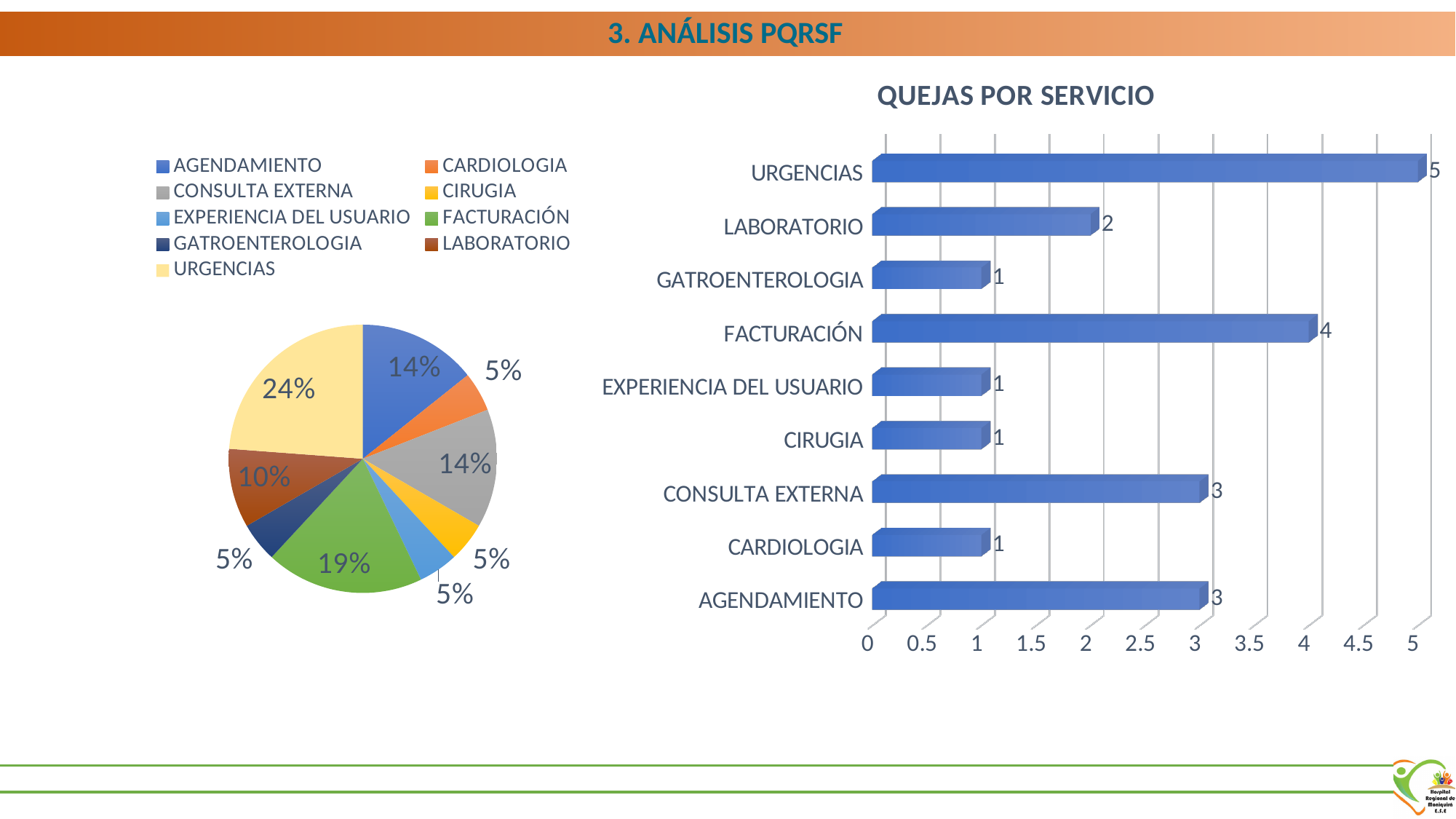
In the bar chart titled QUEJAS POR SERVICIO, how many services are shown? 9 In the bar chart titled QUEJAS POR SERVICIO, which service has the highest value? URGENCIAS In the pie chart on the left, what share does LABORATORIO have? 10% In the pie chart on the left, what share does FACTURACIÓN have? 19% In the bar chart titled QUEJAS POR SERVICIO, which is larger, the value for CONSULTA EXTERNA or the value for LABORATORIO? CONSULTA EXTERNA In the bar chart titled QUEJAS POR SERVICIO, what is the difference between the values for URGENCIAS and LABORATORIO? 3 What kind of chart is the chart titled QUEJAS POR SERVICIO? bar chart In the bar chart titled QUEJAS POR SERVICIO, what is the value for URGENCIAS? 5 In the bar chart titled QUEJAS POR SERVICIO, what is the value for FACTURACIÓN? 4 In the pie chart on the left, which category has the largest slice? URGENCIAS In the pie chart on the left, what share does URGENCIAS have? 24% How many entries does the legend of the pie chart on the left list? 9